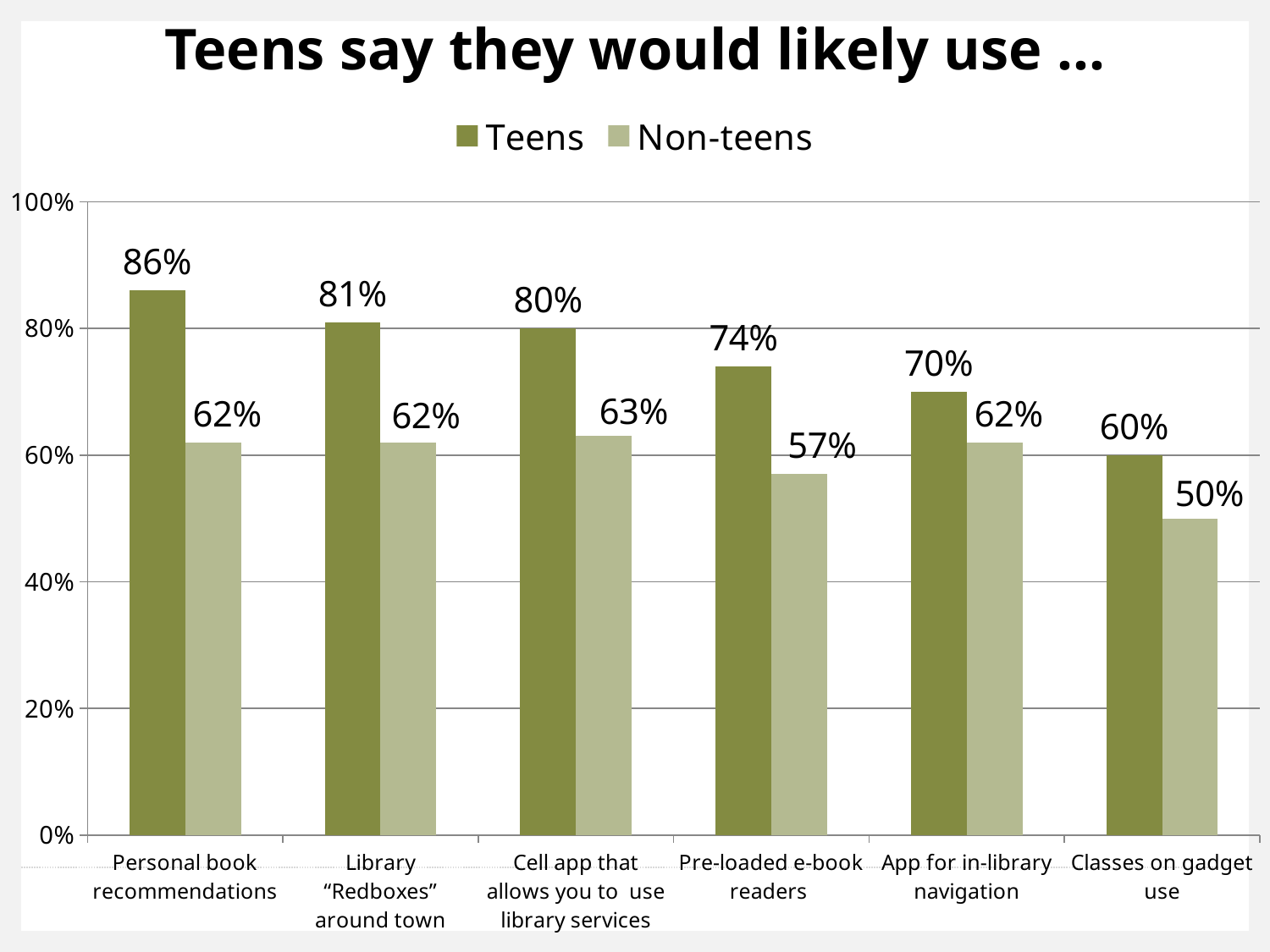
How many categories are shown on the x axis? 6 Which category has the highest Teens value? Personal book recommendations What is the Teens value for classes on gadget use? 60% Do the Teens values rise or fall from left to right along the x axis? Fall How many series does the legend list? 2 What percentage of teens say they would likely use personal book recommendations? 86% What is the Non-teens value for pre-loaded e-book readers? 57% What kind of chart is shown on the slide? Bar chart Which is larger: the Teens value for pre-loaded e-book readers or the Non-teens value for cell app that allows you to use library services? Teens value for pre-loaded e-book readers What is the difference between the Teens values for library "Redboxes" around town and app for in-library navigation? 11% Which category has the lowest Non-teens value? Classes on gadget use What is the difference between the Teens and Non-teens values for personal book recommendations? 24%